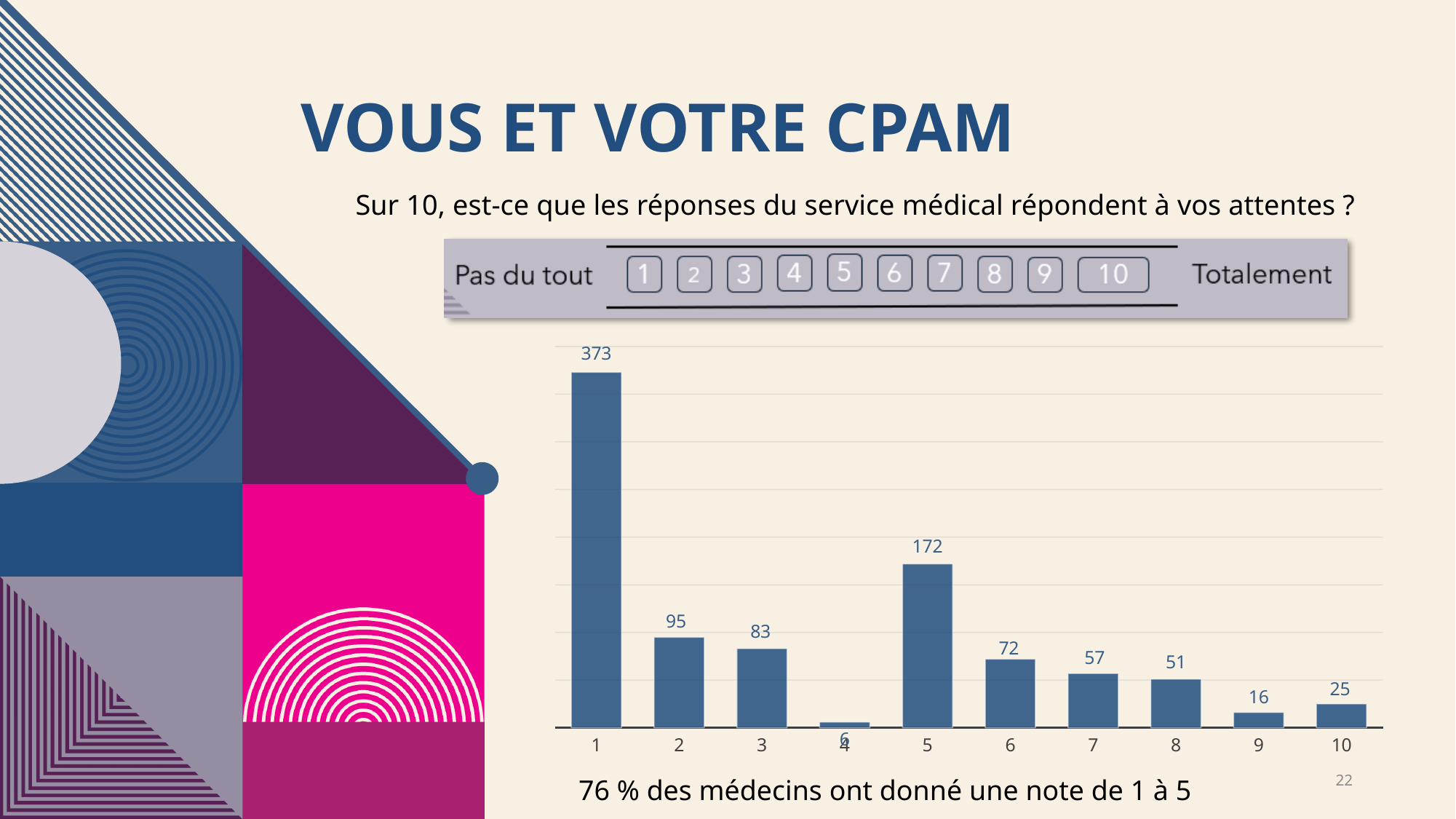
What kind of chart is shown on the slide? bar chart What is the value for category 5? 172 Which is larger, the value for category 9 or the value for category 10? 10 Which category has the lowest value? 4 What is the value for category 8? 51 Which category has the highest value? 1 What question is the chart answering, according to the text above it? Sur 10, est-ce que les réponses du service médical répondent à vos attentes ? What is the difference between the values for category 2 and category 3? 12 What is the value for category 1? 373 What is the difference between the values for category 1 and category 5? 201 What is the value for category 10? 25 How many categories are shown on the x axis? 10